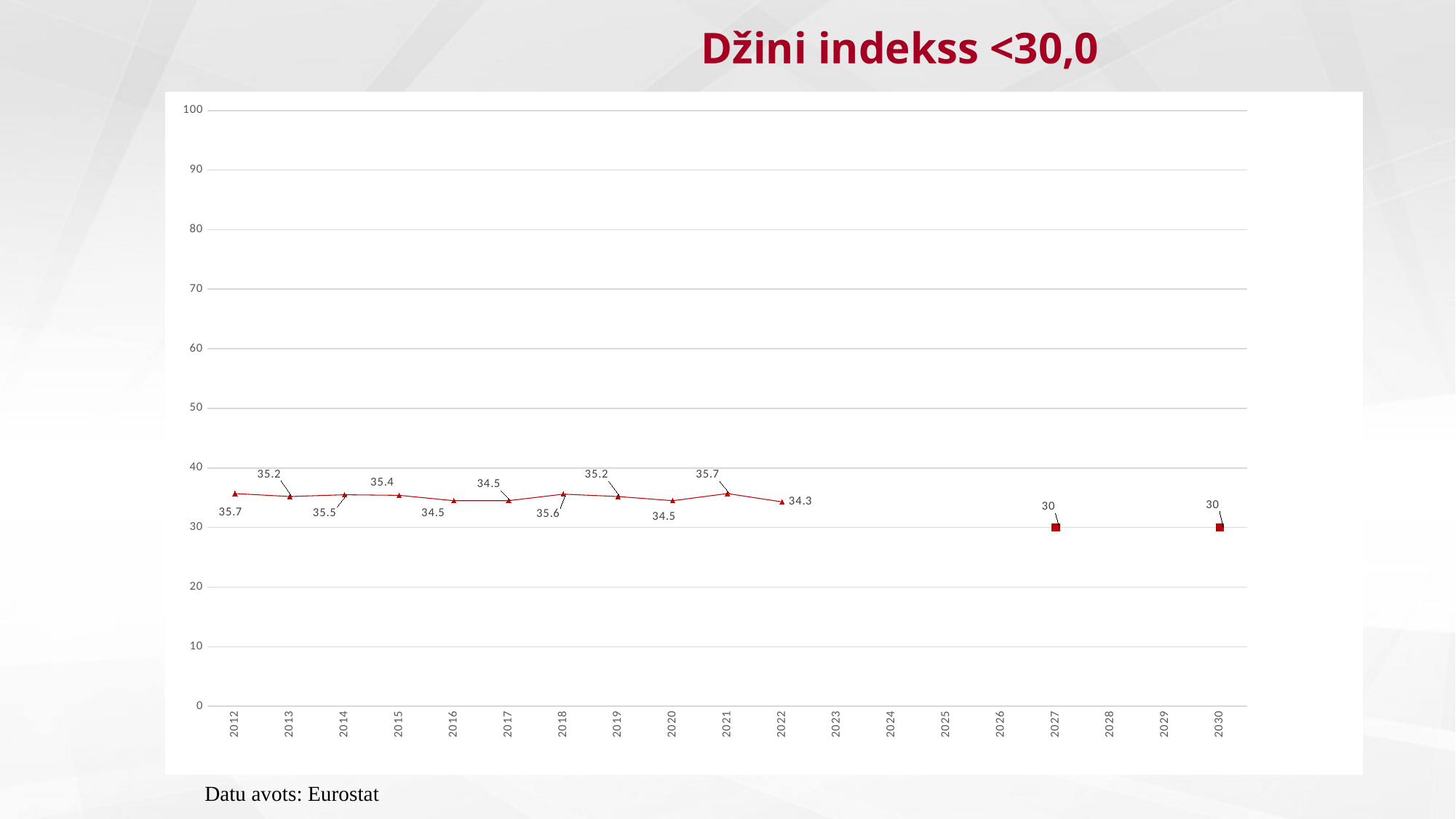
What is the value for 2012? 35.7 What data source is cited below the chart? Eurostat Is the value for 2016 greater or less than 30? greater What is the title of the slide? Džini indekss <30,0 What is the difference between the values for 2012 and 2022? 1.4 What is the value for 2018? 35.6 What is the value for 2022? 34.3 What kind of chart is shown on the slide? line chart What is the value shown for 2027? 30 Which is larger, the value for 2021 or the value for 2020? 2021 How many years are labelled on the x axis? 19